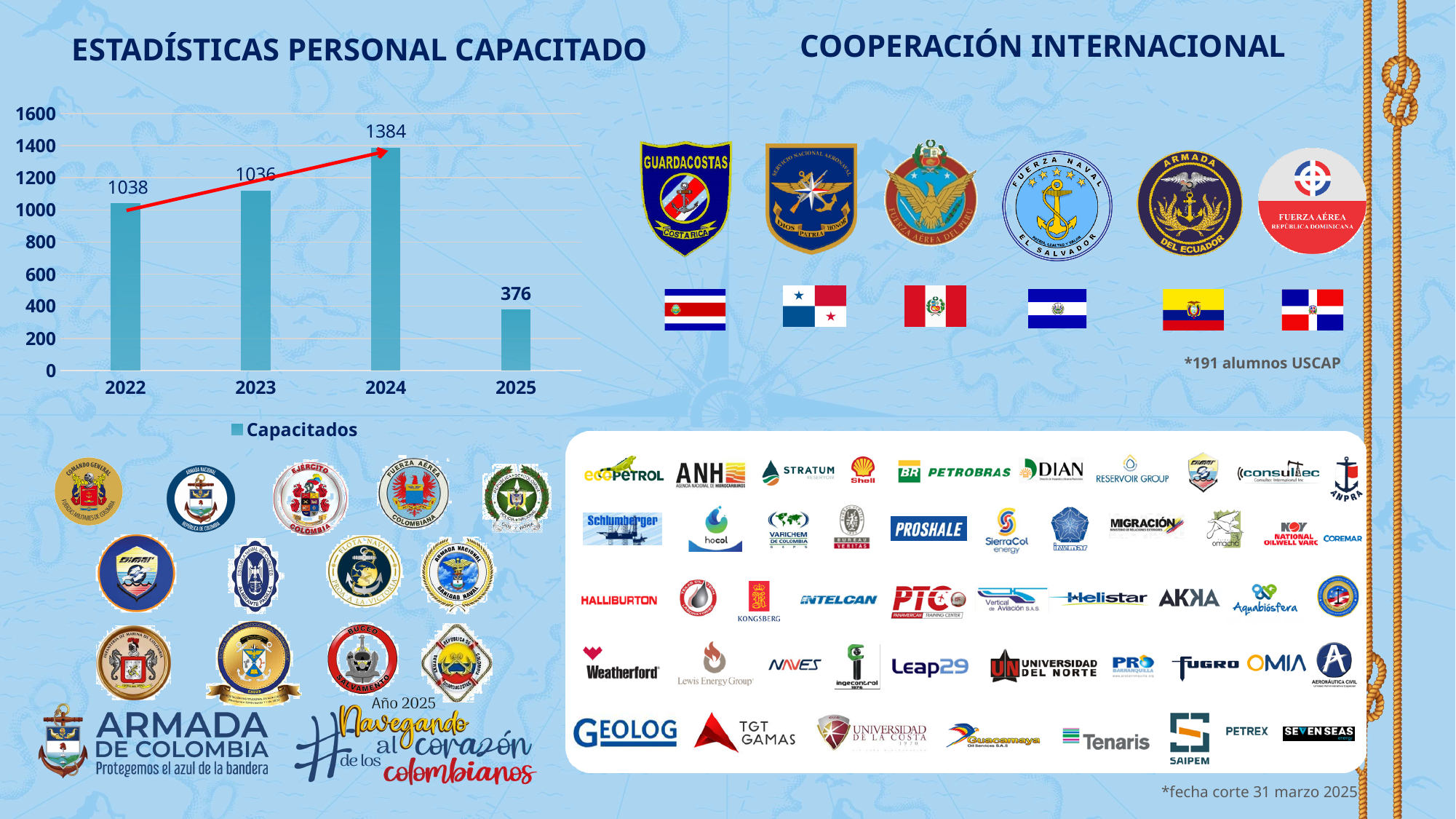
What is the value for 2023 in the ESTADÍSTICAS PERSONAL CAPACITADO chart? 1036 What series name does the legend of the ESTADÍSTICAS PERSONAL CAPACITADO chart show? Capacitados What is the difference between the values for 2024 and 2022 in the ESTADÍSTICAS PERSONAL CAPACITADO chart? 346 Which year has the highest value in the ESTADÍSTICAS PERSONAL CAPACITADO chart? 2024 How many years are shown on the x axis of the ESTADÍSTICAS PERSONAL CAPACITADO chart? 4 What type of chart is the ESTADÍSTICAS PERSONAL CAPACITADO chart? Bar chart What is the value for 2025 in the ESTADÍSTICAS PERSONAL CAPACITADO chart? 376 Which year has the lowest value in the ESTADÍSTICAS PERSONAL CAPACITADO chart? 2025 In the ESTADÍSTICAS PERSONAL CAPACITADO chart, which is larger, the value for 2024 or the value for 2025? 2024 What is the value for 2022 in the ESTADÍSTICAS PERSONAL CAPACITADO chart? 1038 What is the value for 2024 in the ESTADÍSTICAS PERSONAL CAPACITADO chart? 1384 What is the difference between the values for 2024 and 2025 in the ESTADÍSTICAS PERSONAL CAPACITADO chart? 1008